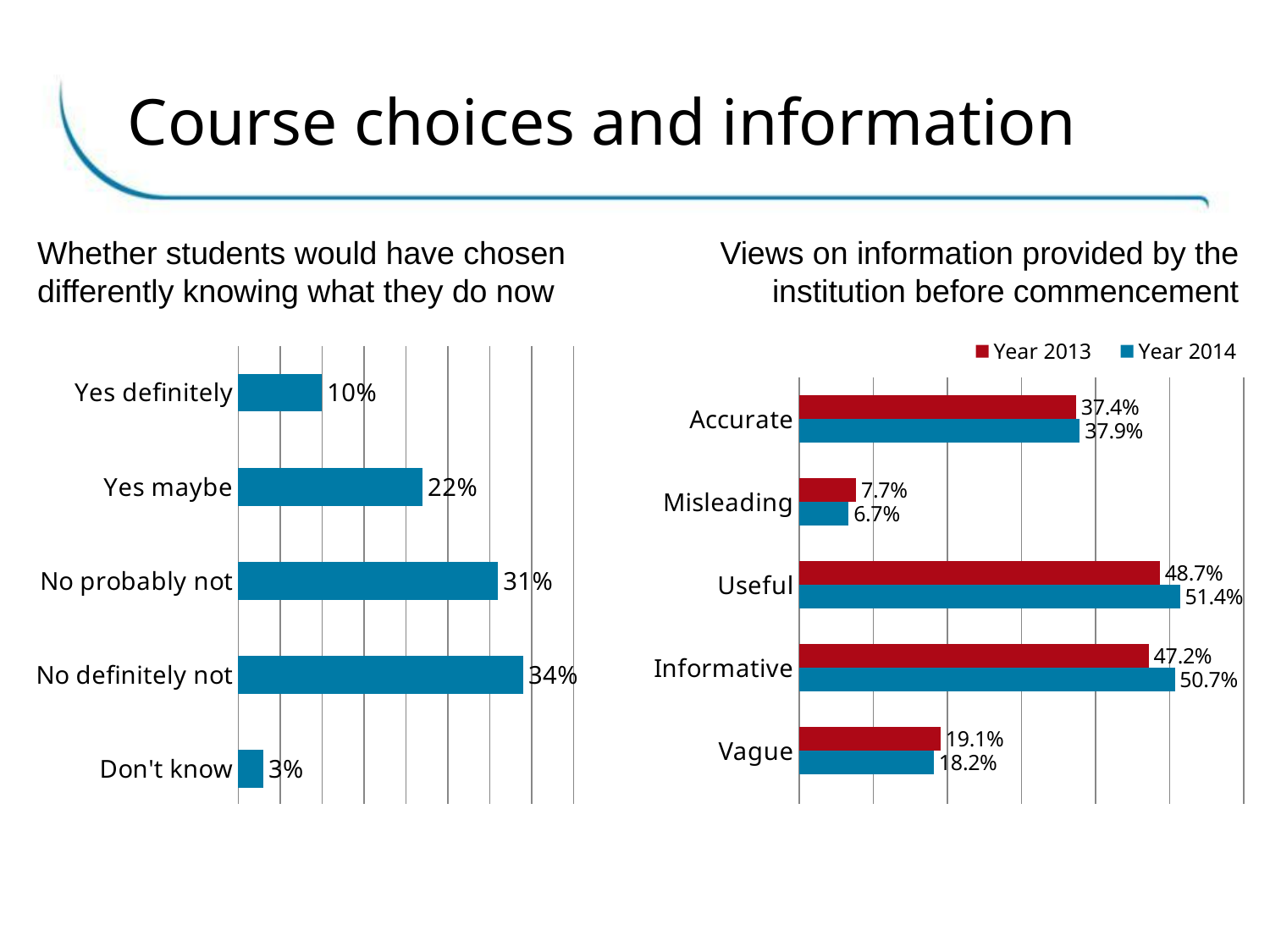
In the left chart (whether students would have chosen differently), which category has the lowest value? Don't know In the right chart (views on information provided by the institution), what is the Year 2014 value for 'Useful'? 51.4% In the right chart (views on information provided by the institution), what is the Year 2013 value for 'Vague'? 19.1% In the right chart (views on information provided by the institution), which is larger for 'Informative': Year 2013 or Year 2014? Year 2014 What type of chart is the left chart (whether students would have chosen differently)? Bar chart In the right chart (views on information provided by the institution), how many series does the legend list? 2 In the left chart (whether students would have chosen differently), what is the difference between 'No definitely not' and 'Yes definitely'? 24% In the left chart (whether students would have chosen differently), how many categories are shown? 5 In the left chart (whether students would have chosen differently), what is the value for 'Yes maybe'? 22% In the right chart (views on information provided by the institution), which category has the lowest Year 2014 value? Misleading In the right chart (views on information provided by the institution), what is the difference between the Year 2013 and Year 2014 values for 'Misleading'? 1.0% In the left chart (whether students would have chosen differently), which category has the highest value? No definitely not